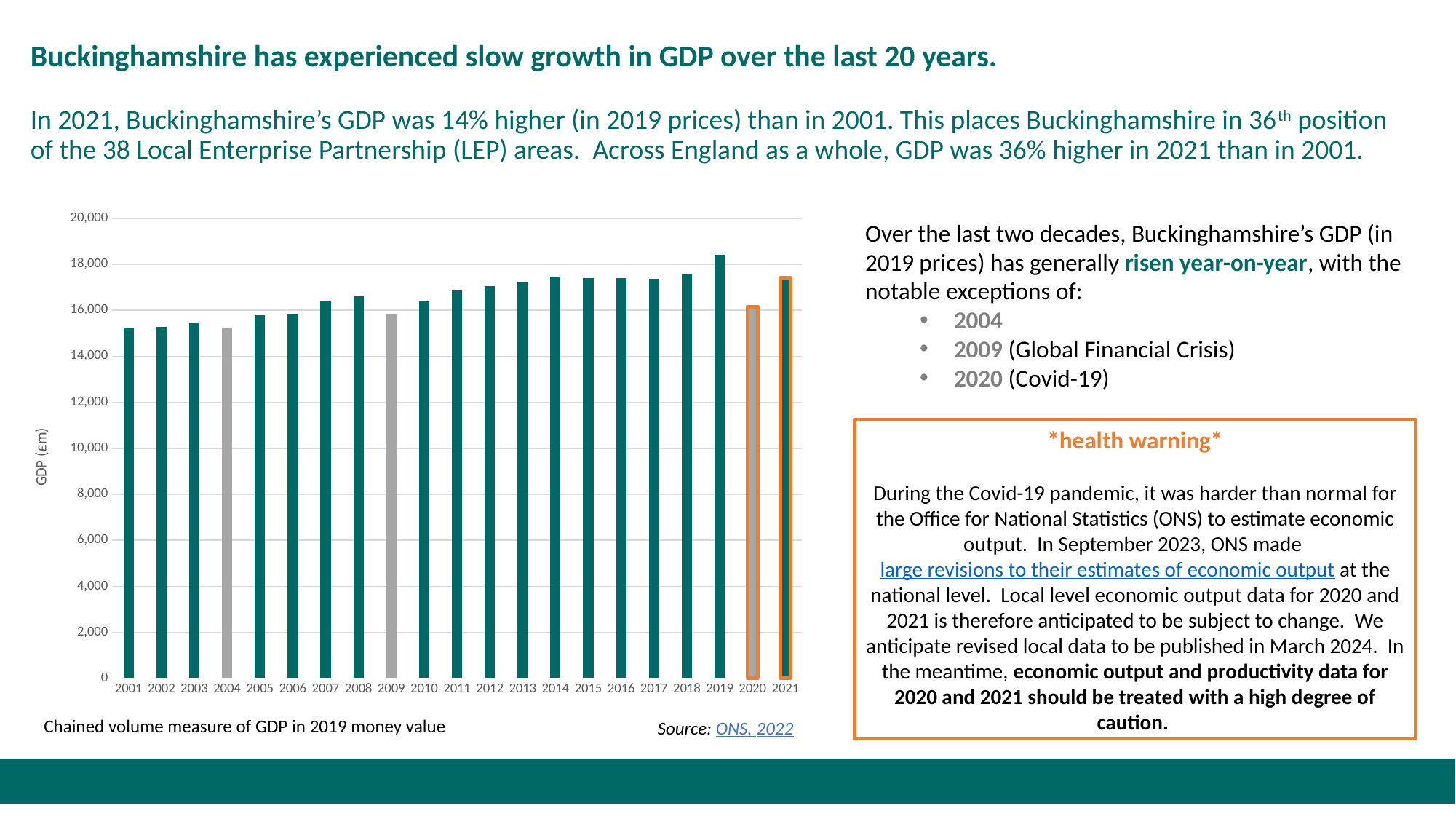
Which year has the larger GDP value, 2008 or 2009? 2008 What kind of chart is shown on the slide? bar chart Overall, do the GDP values rise or fall from 2001 to 2021? rise Which year has the highest GDP value in the chart? 2019 Is the GDP value for 2001 greater or less than 16,000? less Which year has the larger GDP value, 2019 or 2021? 2019 Is the GDP value for 2021 greater or less than 16,000? greater What is the label on the y axis of the chart? GDP (£m) Which year has the larger GDP value, 2020 or 2021? 2021 How many years are plotted on the x axis of the chart? 21 Is the GDP value for 2019 greater or less than 18,000? greater